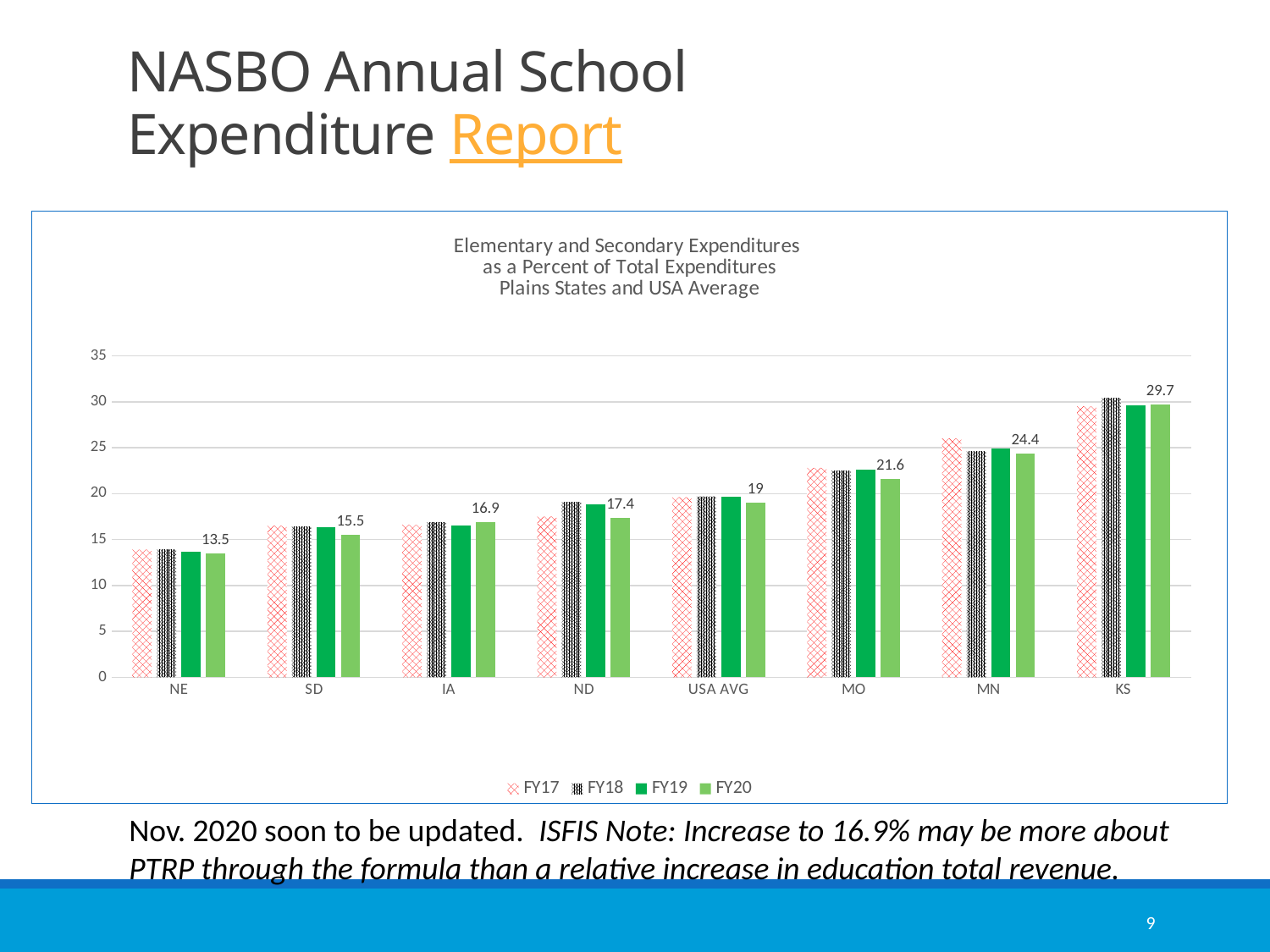
What is the FY20 value for IA? 16.9 What is the difference between the FY20 values for MN and MO? 2.8 What kind of chart is shown on the slide? Bar chart How many series does the legend list? 4 What is the FY20 value for USA AVG? 19 Is the FY17 value for KS greater or less than 25? greater Which state has the highest FY20 value? KS What is the FY20 value for NE? 13.5 How many categories are shown on the x axis? 8 Which has the larger FY20 value, SD or ND? ND What is the FY20 value for KS? 29.7 Which state has the lowest FY20 value? NE